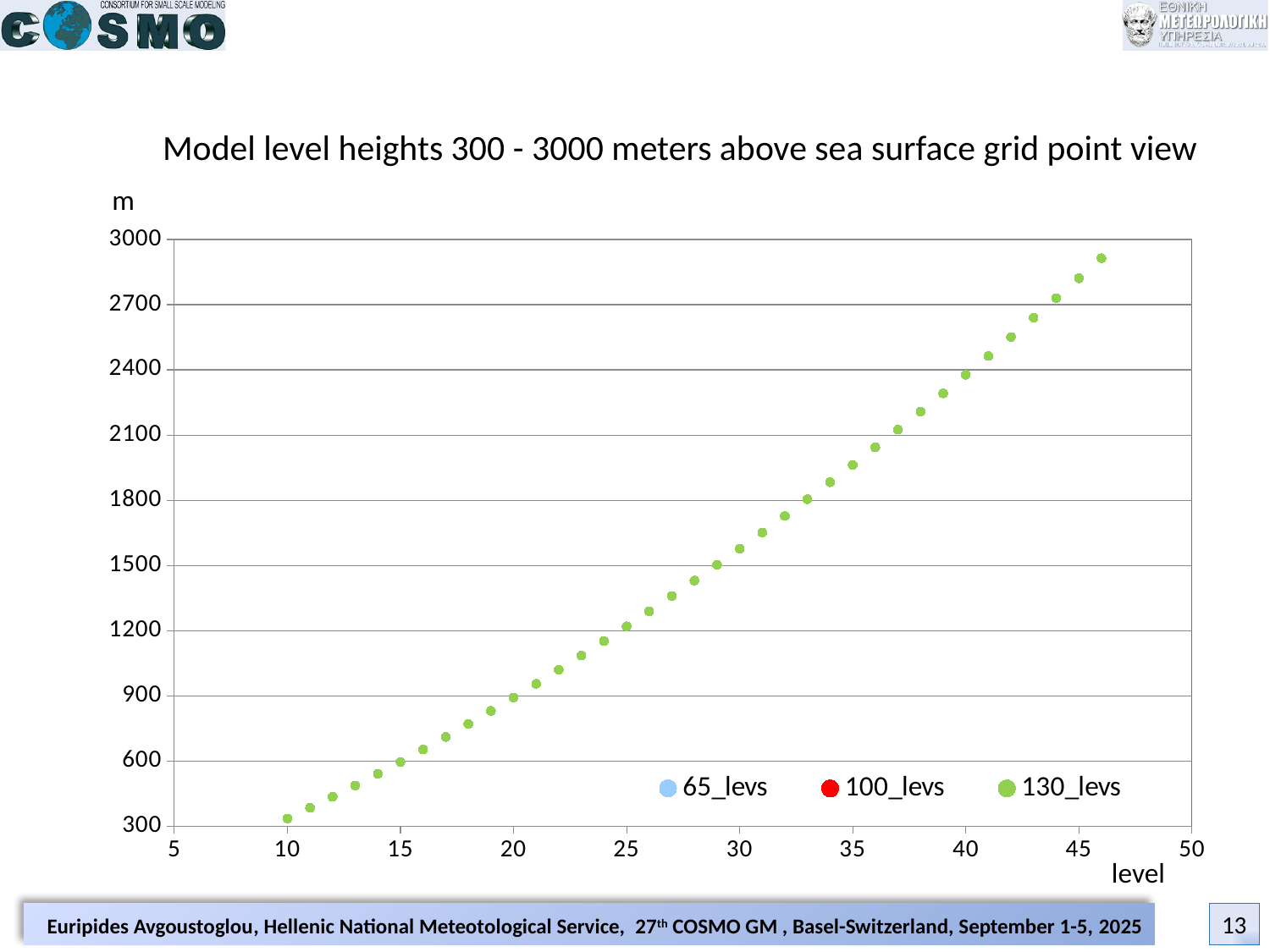
Do the plotted heights rise or fall as the level increases along the x axis? rise Is the value for level 20 greater or less than 1200? less Is the value for level 45 greater or less than 2700? greater Is the value for level 30 greater or less than 1500? greater What is the label of the x axis? level Which has the larger height, level 40 or level 20? level 40 How many series does the legend list? 3 What is the title of the chart? Model level heights 300 - 3000 meters above sea surface grid point view What kind of chart is shown on the slide? scatter chart